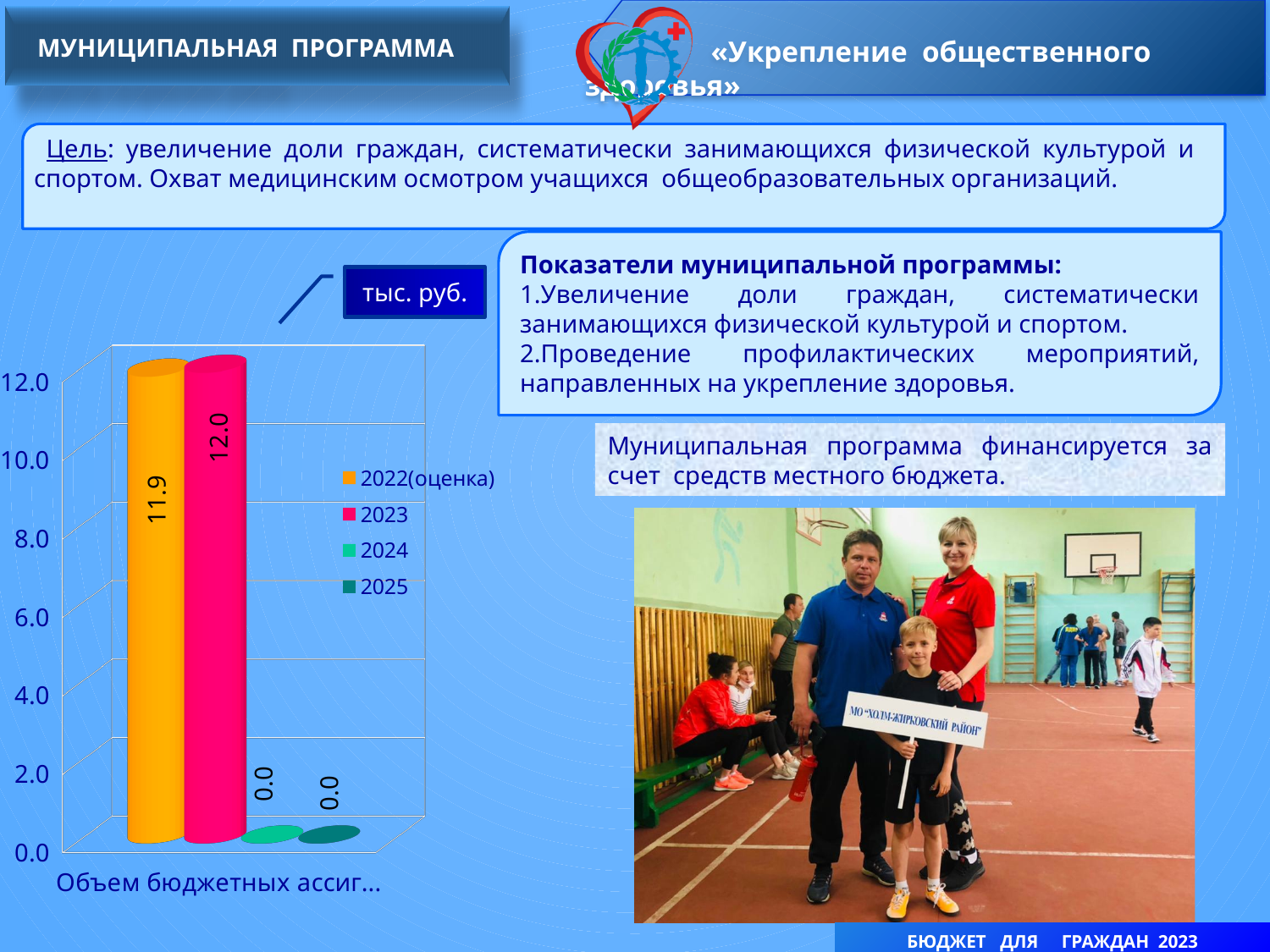
What kind of chart is shown on the slide? bar chart How many series does the legend list? 4 What unit is shown in the box above the chart? тыс. руб. What is the difference between the 2023 value and the 2022(оценка) value? 0.1 What is the value for the 2023 series in the chart? 12.0 What is the value for the 2025 series in the chart? 0.0 Is the value for 2022(оценка) greater or less than 10.0? greater Which series has the highest value in the chart? 2023 What colour is the bar for the 2023 series? pink What is the value for the 2024 series in the chart? 0.0 What is the value for the 2022(оценка) series in the chart? 11.9 Which is larger, the value for 2022(оценка) or the value for 2023? 2023